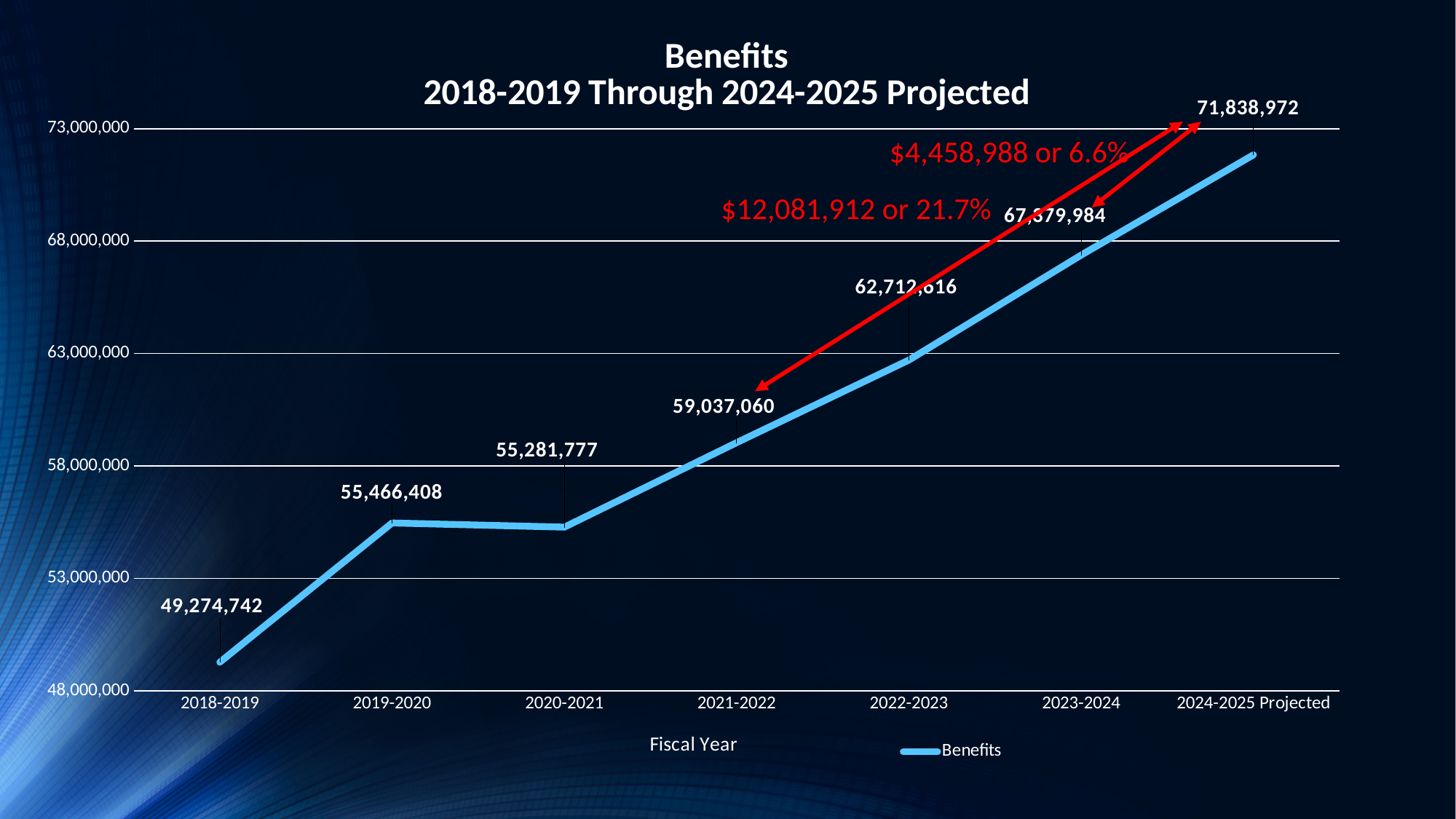
What is the Benefits value for 2024-2025 Projected? 71,838,972 What is the difference between the Benefits values for 2019-2020 and 2018-2019? 6,191,666 What type of chart is shown on the slide? Line chart What is the Benefits value for 2021-2022? 59,037,060 Which is larger, the Benefits value for 2019-2020 or for 2020-2021? 2019-2020 How many fiscal years are plotted on the chart? 7 Which fiscal year has the highest Benefits value? 2024-2025 Projected Is the Benefits value for 2021-2022 greater or less than 58,000,000? greater Which fiscal year has the lowest Benefits value? 2018-2019 What is the title of the x axis? Fiscal Year What is the Benefits value for 2018-2019? 49,274,742 How many series does the legend list? 1